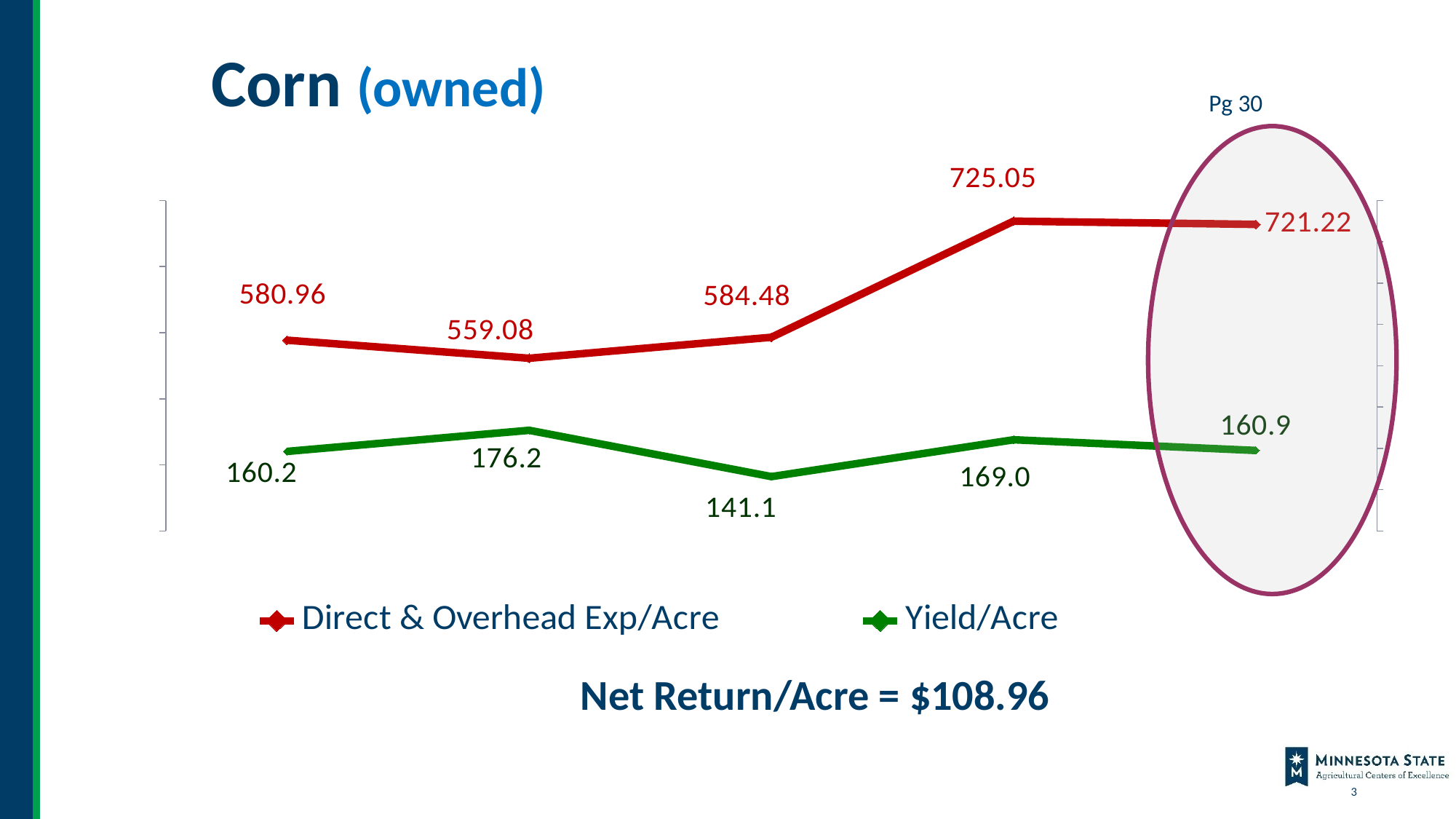
Which is larger: the first Yield/Acre value (160.2) or the last Yield/Acre value (160.9)? 160.9 (the last value) How many series does the legend list? 2 What is the difference between the fourth and fifth values of Direct & Overhead Exp/Acre (725.05 and 721.22)? 3.83 What Net Return/Acre is stated below the chart? $108.96 What is the highest value shown for Yield/Acre? 176.2 How many data points does the Direct & Overhead Exp/Acre line have? 5 What type of chart is shown on the slide? line chart What is the highest value shown for Direct & Overhead Exp/Acre? 725.05 What is the third value of the Yield/Acre series? 141.1 What is the last (fifth) value of the Direct & Overhead Exp/Acre series? 721.22 Does the Direct & Overhead Exp/Acre line rise or fall between the third and fourth points? rise What is the lowest value shown for Yield/Acre? 141.1